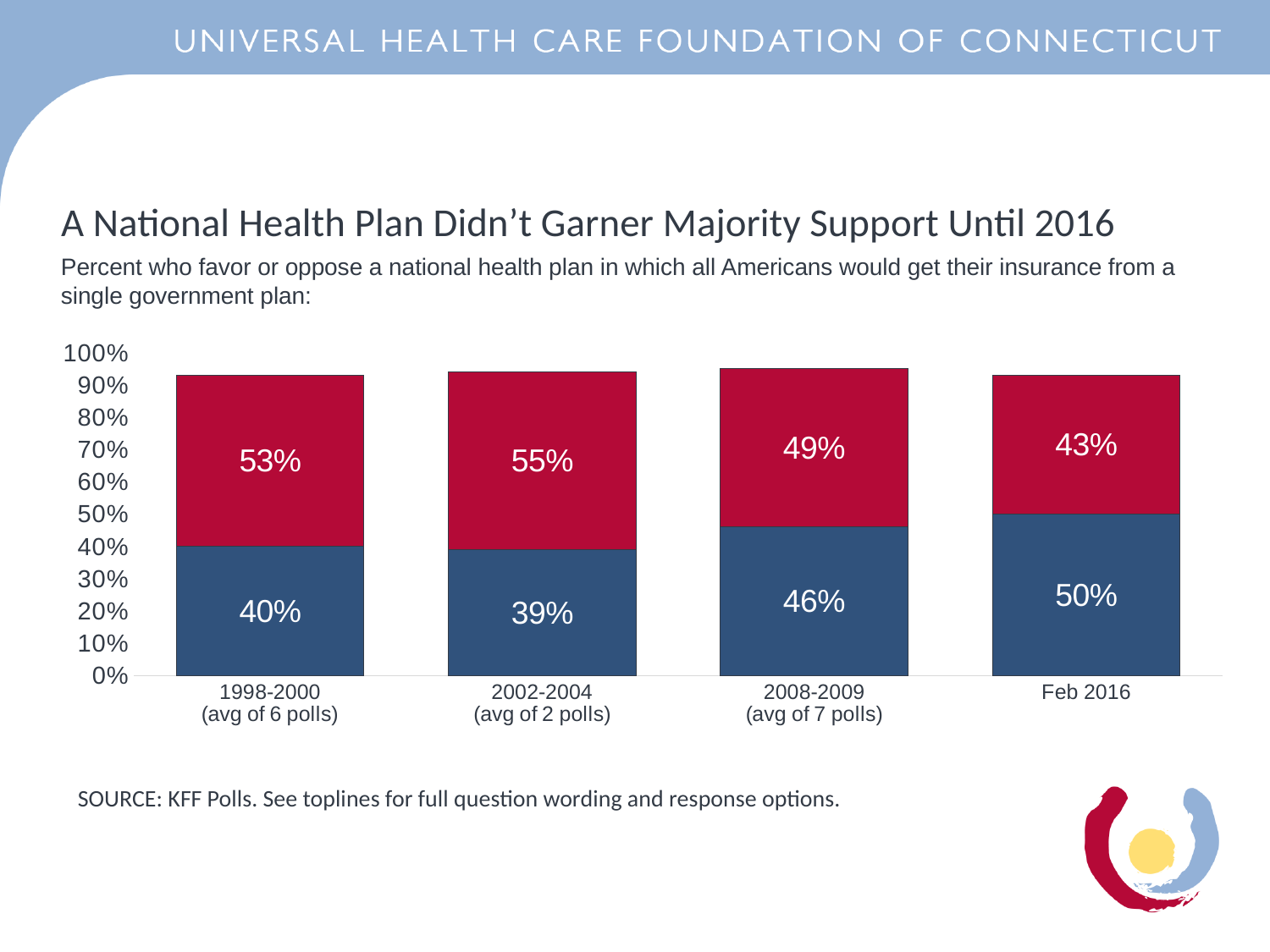
From 2002-2004 to Feb 2016, does the red (top) segment rise or fall? Fall What is the title of the chart? A National Health Plan Didn't Garner Majority Support Until 2016 Which period has the highest value in the red (top) segment? 2002-2004 What kind of chart is shown on the slide? Stacked bar chart What is the total of the stacked bar for 2008-2009? 95% What is the value of the blue (bottom) segment for 2008-2009? 46% For 1998-2000, how much larger is the red segment than the blue segment? 13 percentage points Which is larger: the blue segment for 2008-2009 or the blue segment for Feb 2016? Feb 2016 How many time periods are shown on the x axis? 4 What is the value of the red (top) segment for 2002-2004? 55% What is the value of the blue (bottom) segment for Feb 2016? 50% Which period has the lowest value in the blue (bottom) segment? 2002-2004